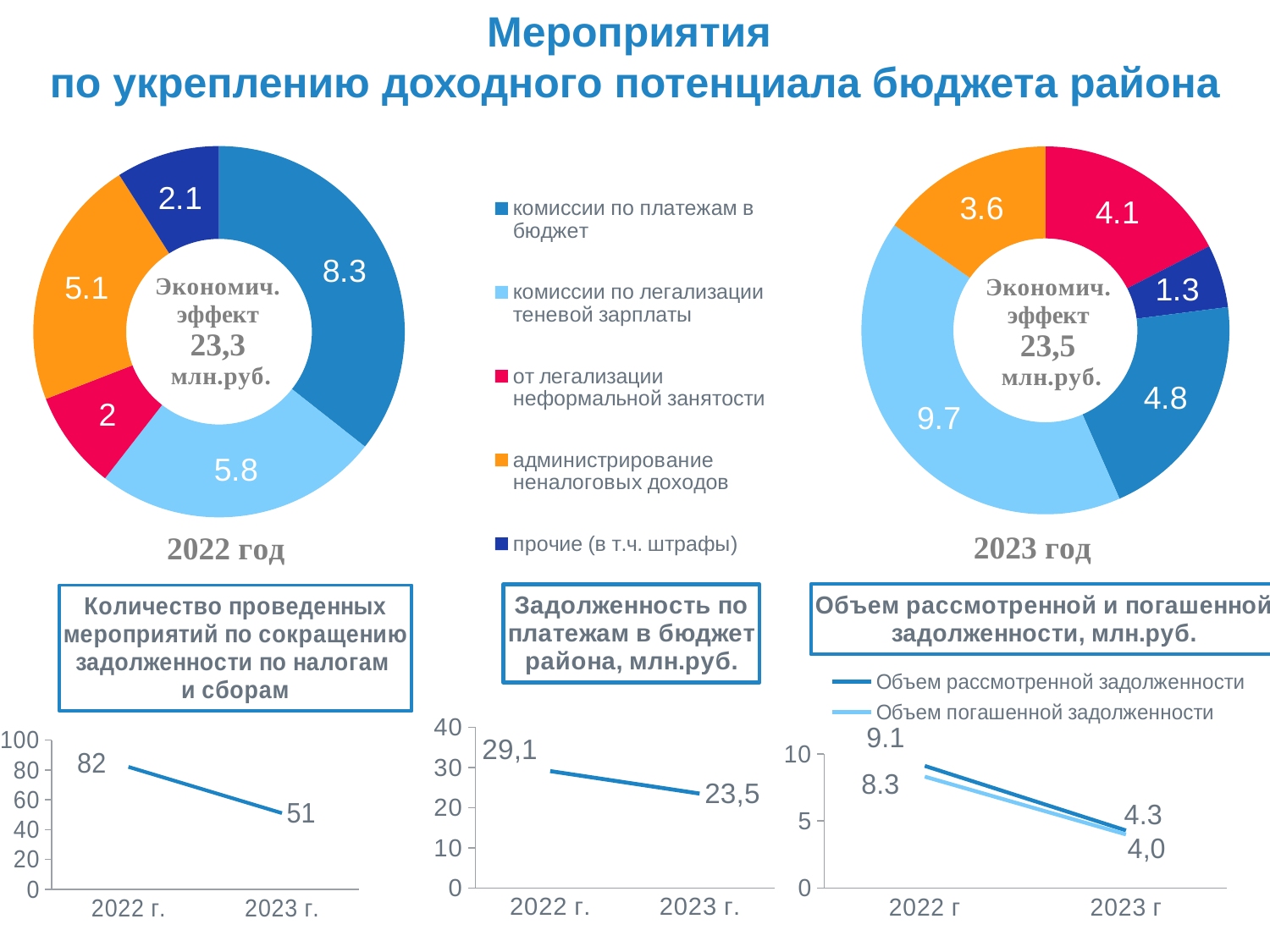
In the chart 'Объем рассмотренной и погашенной задолженности, млн.руб.', do the values rise or fall from 2022 г to 2023 г? fall In the chart 'Объем рассмотренной и погашенной задолженности, млн.руб.', what is the value of Объем погашенной задолженности for 2022 г? 8.3 In the 2022 год donut chart, what is the value for комиссии по платежам в бюджет? 8.3 In the 2023 год donut chart, which category has the largest value? комиссии по легализации теневой зарплаты In the 2022 год donut chart, which is larger: администрирование неналоговых доходов or комиссии по легализации теневой зарплаты? комиссии по легализации теневой зарплаты In the chart 'Задолженность по платежам в бюджет района, млн.руб.', what is the difference between the 2022 г. and 2023 г. values? 5,6 In the 2023 год donut chart, what is the value for комиссии по легализации теневой зарплаты? 9.7 In the 2023 год donut chart, what is the difference between the values for комиссии по платежам в бюджет and прочие (в т.ч. штрафы)? 3.5 How many series does the legend between the two donut charts list? 5 In the 2022 год donut chart, which category has the smallest value? от легализации неформальной занятости What total economic effect (Экономич. эффект) is shown in the centre of the 2023 год donut chart? 23,5 млн.руб. In the chart 'Количество проведенных мероприятий по сокращению задолженности по налогам и сборам', what is the value for 2023 г.? 51